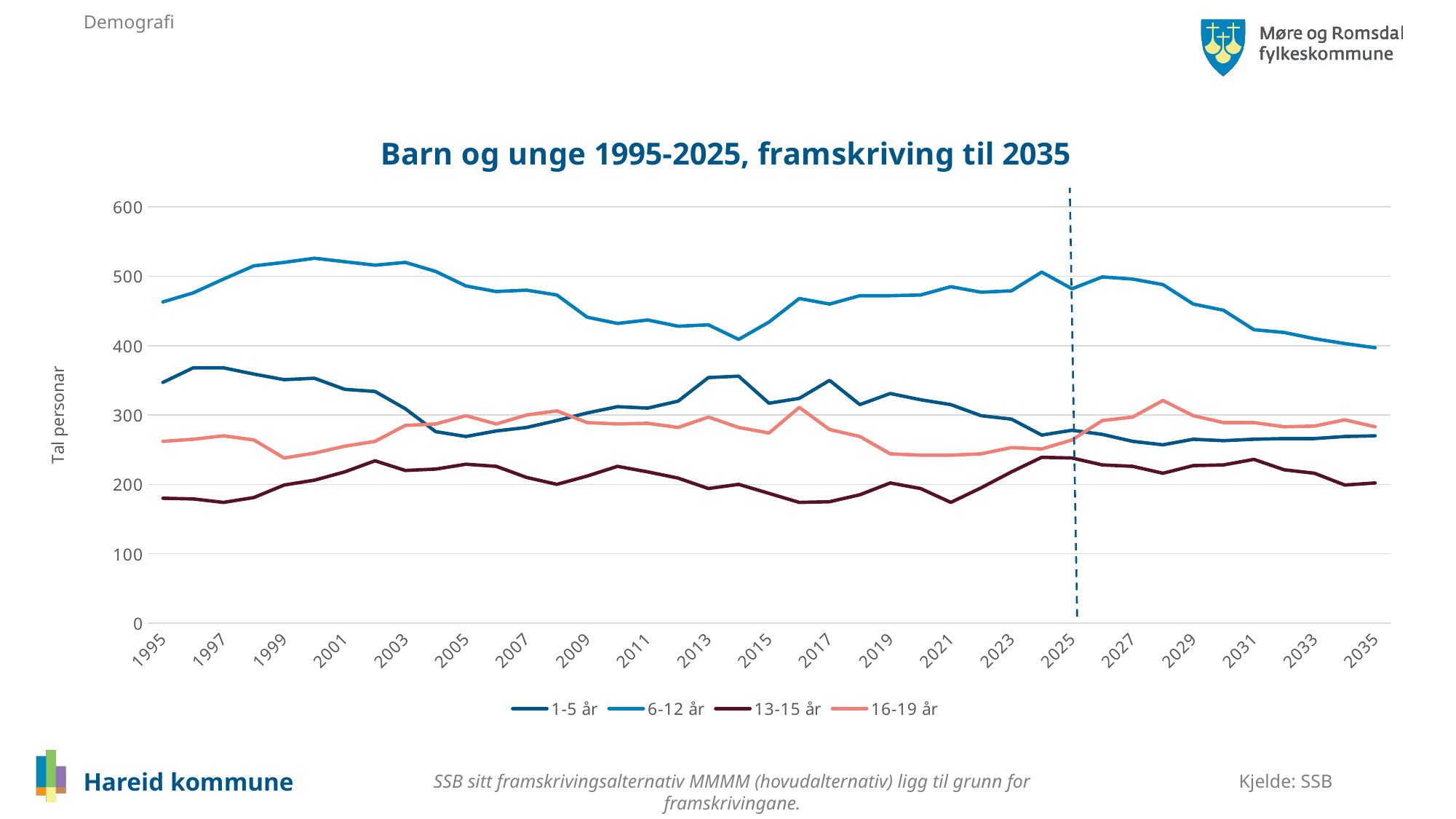
What kind of chart is shown on the slide? line chart How many series does the legend list? 4 Is the value for 16-19 år in 2028 greater or less than 300? greater Is the value for 1-5 år in 1997 greater or less than 350? greater Is the value for 13-15 år in 1995 greater or less than 200? less Does the 6-12 år series rise or fall from 2025 to 2035? fall In 2035, which is larger: 1-5 år or 13-15 år? 1-5 år What is the title of the chart? Barn og unge 1995-2025, framskriving til 2035 Which series has the lowest value in 1995? 13-15 år Which series has the highest values across the whole period? 6-12 år What is the label on the vertical axis? Tal personar